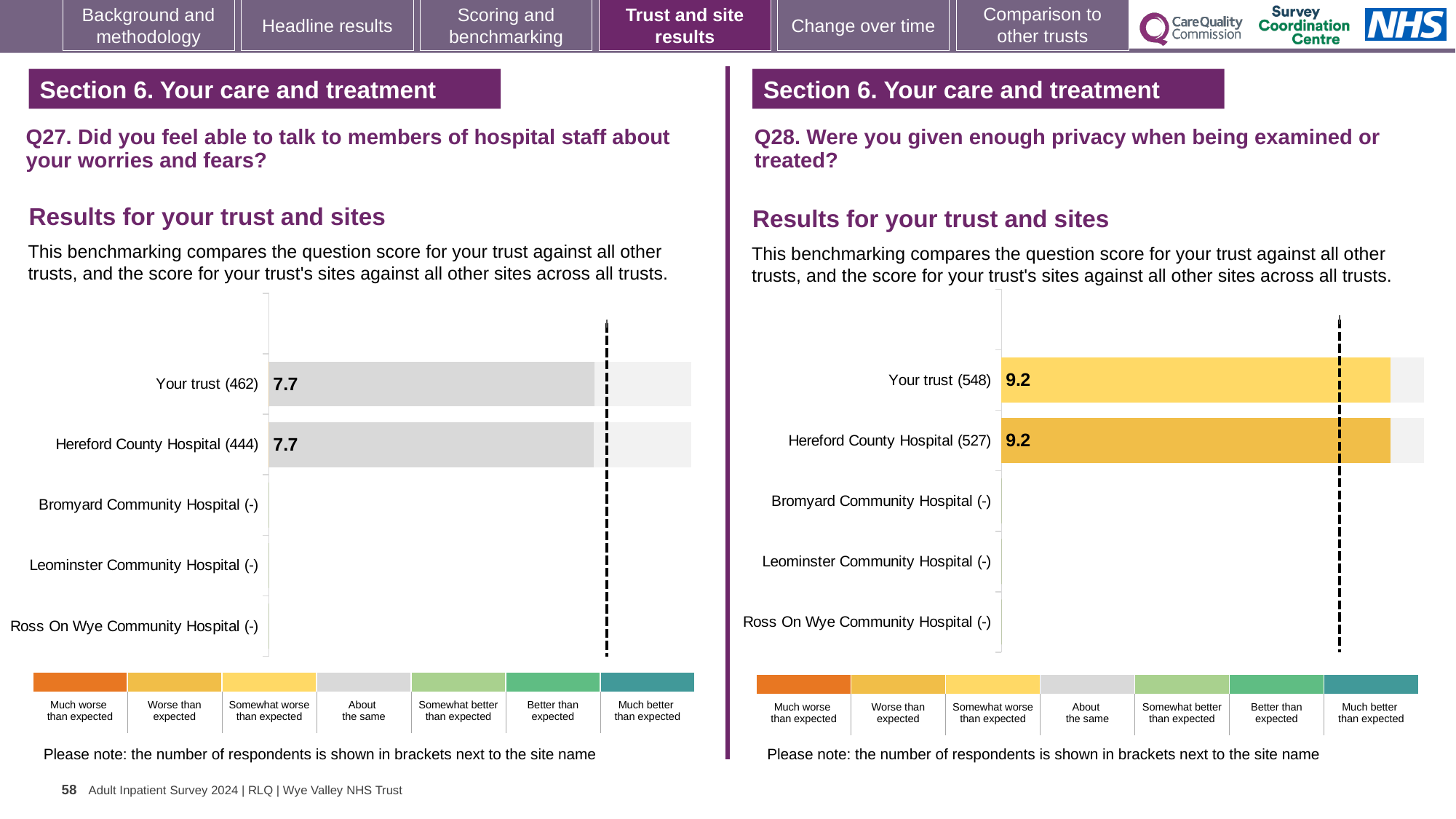
On the Q28 chart (right), what is the score for Your trust? 9.2 On the Q27 chart (left), which benchmark category does the grey colour of the bars correspond to in the legend? About the same On the Q28 chart (right), which benchmark category does the colour of the Hereford County Hospital bar correspond to in the legend? Worse than expected On the Q27 chart (left), how many respondents are shown in brackets for Hereford County Hospital? 444 On the Q27 chart (left), what is the difference between the scores for Your trust and Hereford County Hospital? 0.0 On the Q28 chart (right), what is the score for Hereford County Hospital? 9.2 On the Q28 chart (right), how many respondents are shown in brackets for Your trust? 548 On the Q27 chart (left), how many site/trust categories are listed on the vertical axis? 5 On the Q27 chart (left), what is the score for Hereford County Hospital? 7.7 On the Q27 chart (left), what is the score for Your trust? 7.7 On the Q28 chart (right), how many categories have a plotted bar? 2 What kind of chart is used on the Q28 chart (right)? Bar chart